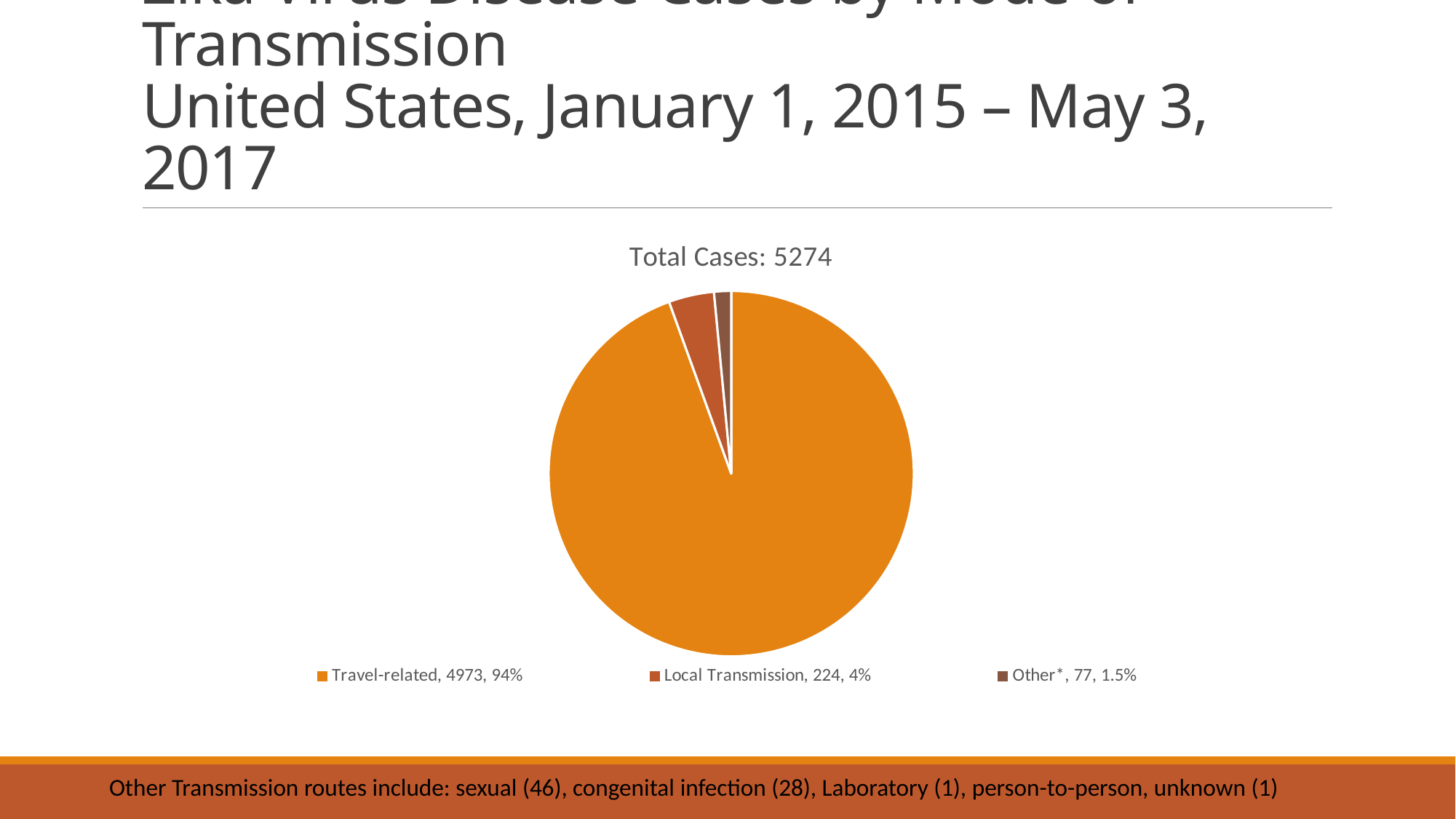
Which mode of transmission has the most cases? Travel-related Which mode of transmission has the fewest cases? Other* How many more cases are Local Transmission than Other*? 147 What share of cases is Travel-related? 94% What kind of chart is shown on the slide? pie chart How many cases are Travel-related? 4973 How many slices does the pie chart have? 3 How many cases are attributed to Local Transmission? 224 What is the chart's title? Total Cases: 5274 How many cases fall under Other*? 77 What share of cases is Other*? 1.5% Which has more cases, Local Transmission or Other*? Local Transmission